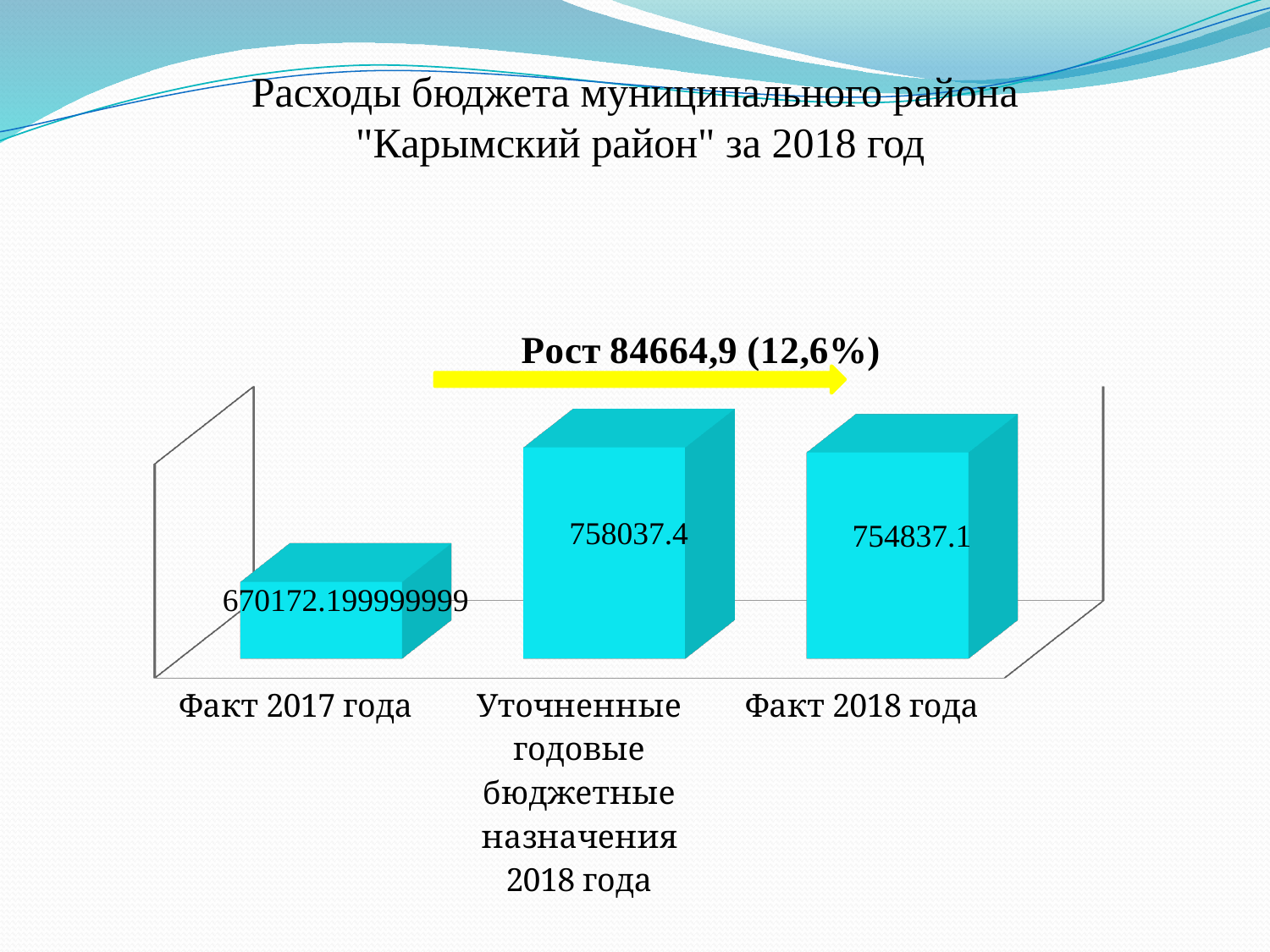
Which is larger, the value for Факт 2018 года or the value for Факт 2017 года? Факт 2018 года Which category has the highest value? Уточненные годовые бюджетные назначения 2018 года What growth is stated in the annotation above the chart? Рост 84664,9 (12,6%) What kind of chart is shown on the slide? Bar chart What is the title of the chart? Рост 84664,9 (12,6%) What is the value for Факт 2018 года? 754837.1 Which category has the lowest value? Факт 2017 года What is the value for Факт 2017 года? 670172.199999999 What is the value for Уточненные годовые бюджетные назначения 2018 года? 758037.4 What is the difference between the value for Уточненные годовые бюджетные назначения 2018 года and the value for Факт 2018 года? 3200.3 How many categories are shown in the chart? 3